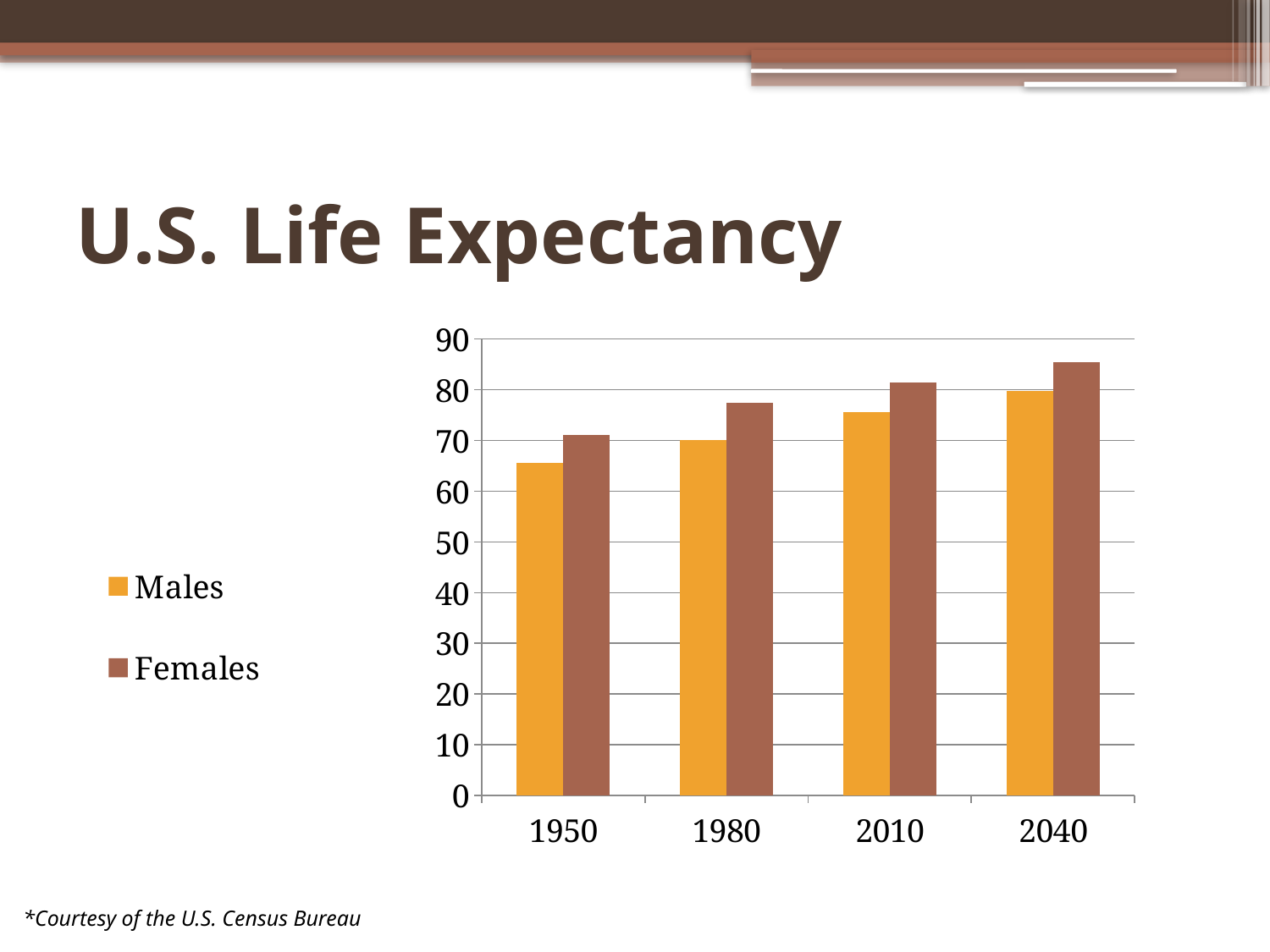
How many series does the legend list? 2 Is the value for Males in 2010 greater or less than 70? greater Which is larger: the Males value in 2040 or the Females value in 1950? Males in 2040 Is the value for Females in 1980 greater or less than 80? less Is the value for Males in 1950 greater or less than 70? less How many years are shown on the x axis? 4 What kind of chart is shown on the slide? bar chart What is the title of the slide containing the chart? U.S. Life Expectancy In which year is the Males value lowest? 1950 Which series is shown in orange in the legend? Males In which year is the Females value highest? 2040